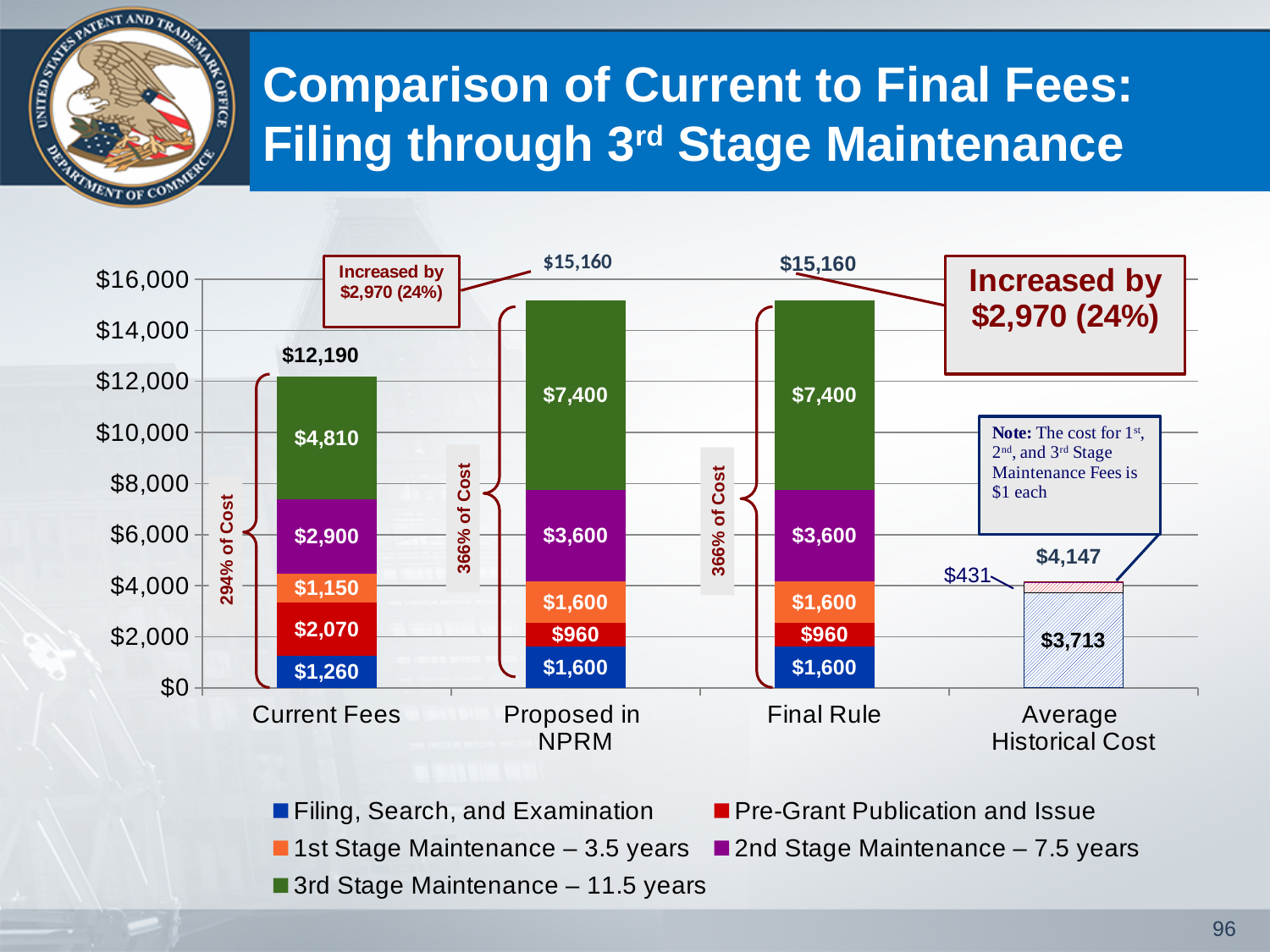
What is the value of Pre-Grant Publication and Issue for Final Rule? $960 How many categories are shown along the x axis? 4 What is the total for the Current Fees bar? $12,190 How many series does the legend list? 5 Which is larger: 1st Stage Maintenance – 3.5 years for Current Fees or for Final Rule? Final Rule What is the total for the Final Rule bar? $15,160 Which category has the lowest total bar? Average Historical Cost What is the value of 3rd Stage Maintenance – 11.5 years for Current Fees? $4,810 What is the value of 2nd Stage Maintenance – 7.5 years for Proposed in NPRM? $3,600 What is the difference between the Final Rule total and the Current Fees total? $2,970 What kind of chart is shown on the slide? Stacked bar chart What is the value of Filing, Search, and Examination for Current Fees? $1,260